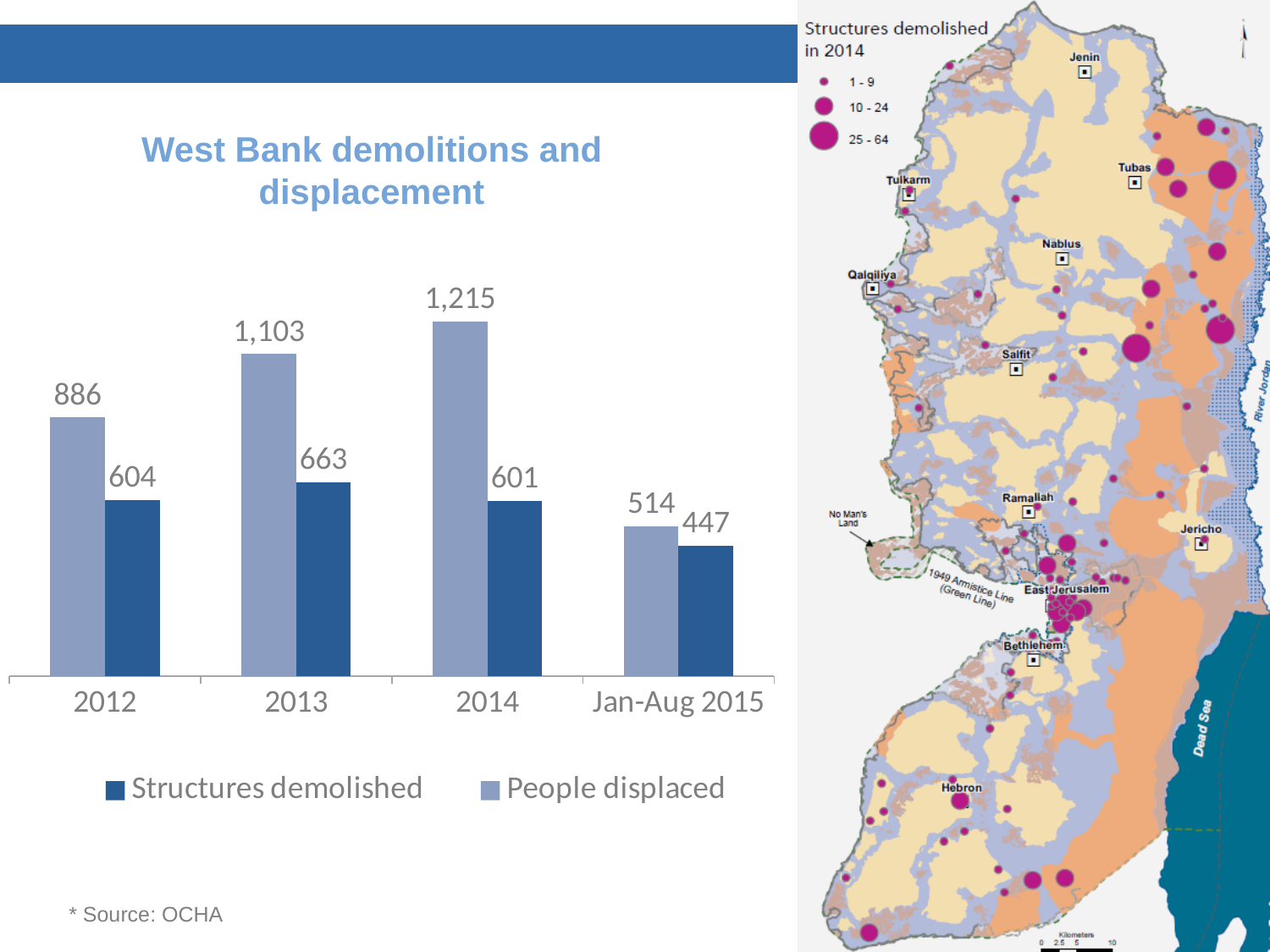
In which period is the value for Structures demolished lowest? Jan-Aug 2015 In which period is the value for People displaced highest? 2014 What type of chart is shown on the left of the slide? bar chart What is the title of the chart? West Bank demolitions and displacement Which series is shown in dark blue in the chart? Structures demolished Which is larger in 2013: People displaced or Structures demolished? People displaced How many categories are shown on the x axis of the chart? 4 What is the value for People displaced in 2014? 1,215 What is the value for Structures demolished in Jan-Aug 2015? 447 What is the difference between People displaced and Structures demolished in 2012? 282 What is the value for Structures demolished in 2013? 663 How many series does the chart legend list? 2